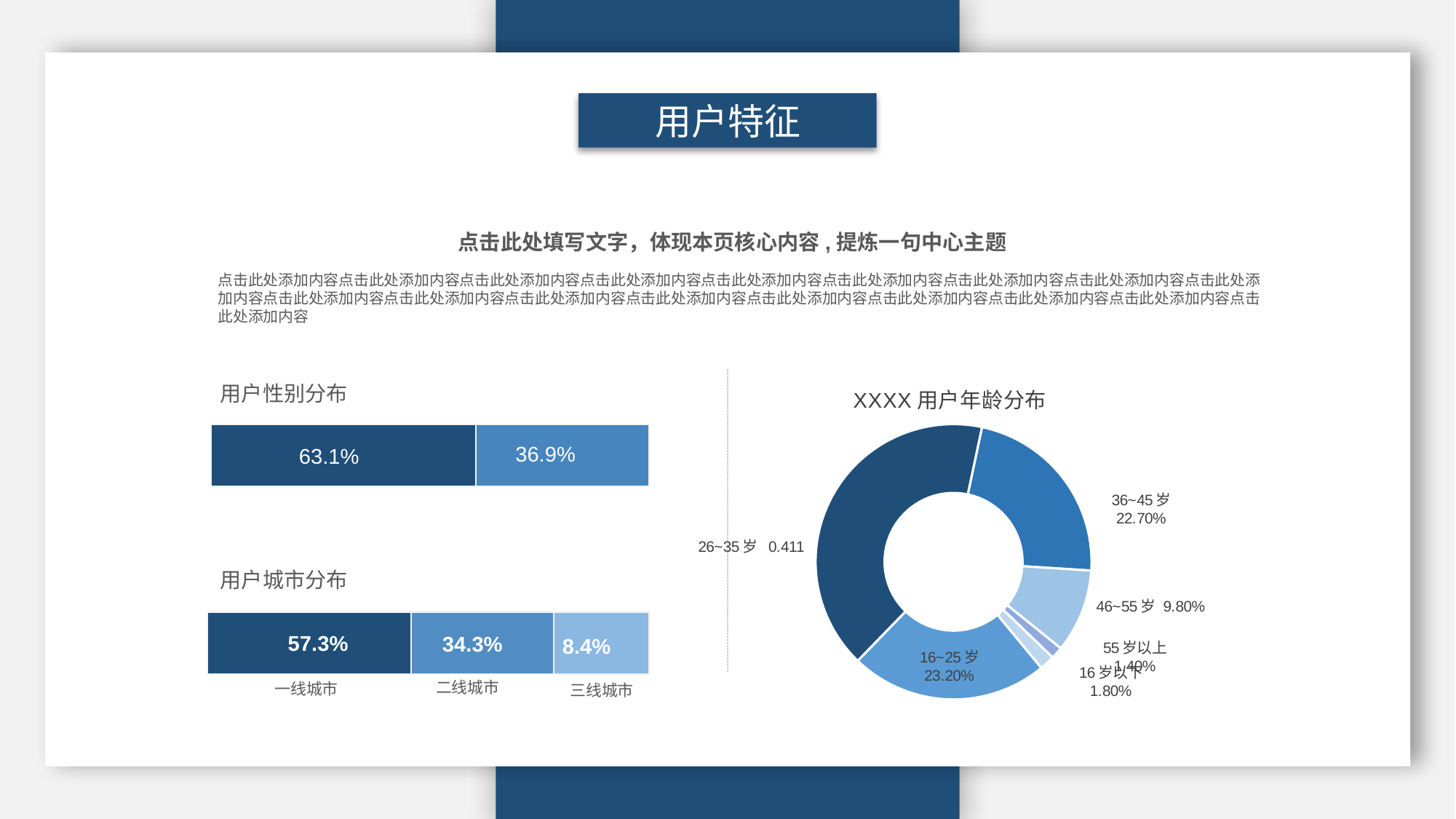
In the 用户性别分布 chart, what is the difference between the two segments? 26.2% In the 用户城市分布 chart, what is the value for 一线城市? 57.3% In the 用户城市分布 chart, how many city categories are shown? 3 In the XXXX 用户年龄分布 chart, what is the value for 36~45 岁? 22.70% In the 用户城市分布 chart, which category has the lowest value? 三线城市 In the 用户城市分布 chart, what is the value for 三线城市? 8.4% In the XXXX 用户年龄分布 chart, which is larger, 16~25 岁 or 36~45 岁? 16~25 岁 In the XXXX 用户年龄分布 chart, which age group has the largest share? 26~35 岁 In the 用户性别分布 chart, what is the value of the larger segment? 63.1% In the 用户城市分布 chart, what is the difference between 一线城市 and 二线城市? 23.0% In the XXXX 用户年龄分布 chart, what is the value for 46~55 岁? 9.80% What kind of chart is the XXXX 用户年龄分布 chart? Doughnut chart